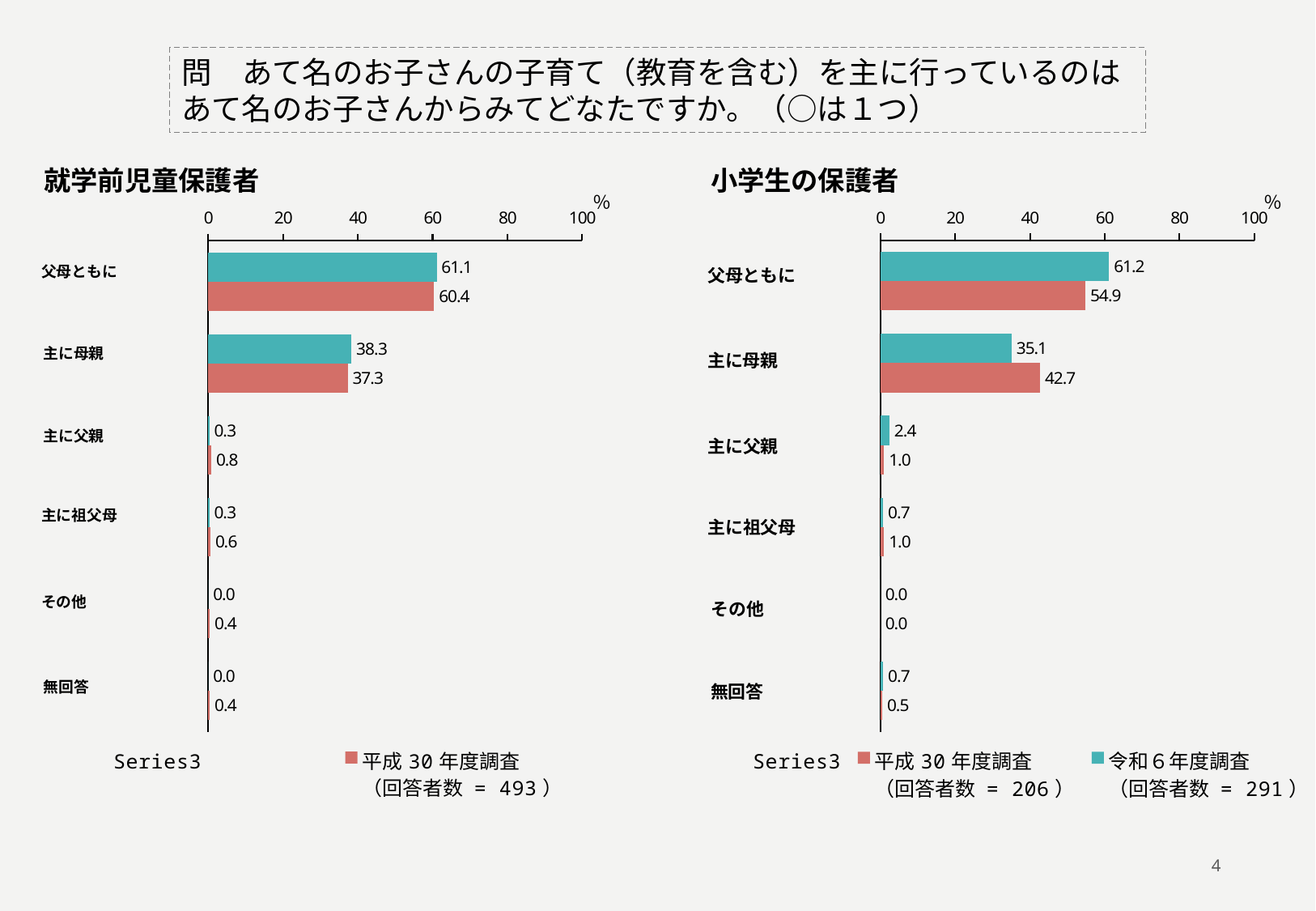
According to the legend of the 小学生の保護者 chart, how many respondents were in the 令和６年度調査? 291 In the 小学生の保護者 chart, what is the difference between the 令和６年度調査 and 平成30年度調査 values for 父母ともに? 6.3 What type of chart is the 小学生の保護者 chart? bar chart In the 小学生の保護者 chart, what is the value for 主に母親 in the 平成30年度調査 series? 42.7 In the 就学前児童保護者 chart, what is the value for 主に母親 in the 平成30年度調査 series? 37.3 In the 小学生の保護者 chart, which is larger for 主に母親: the 令和６年度調査 value or the 平成30年度調査 value? 平成30年度調査 In the 就学前児童保護者 chart, is the teal bar for 主に母親 greater or less than 40? less In the 就学前児童保護者 chart, what is the value of the teal bar for 父母ともに? 61.1 In the 小学生の保護者 chart, what is the value for 主に父親 in the 令和６年度調査 series? 2.4 In the 小学生の保護者 chart, which category has the highest value in the 平成30年度調査 series? 父母ともに In the 小学生の保護者 chart, what is the value for 父母ともに in the 令和６年度調査 series? 61.2 How many categories are shown in the 就学前児童保護者 chart? 6